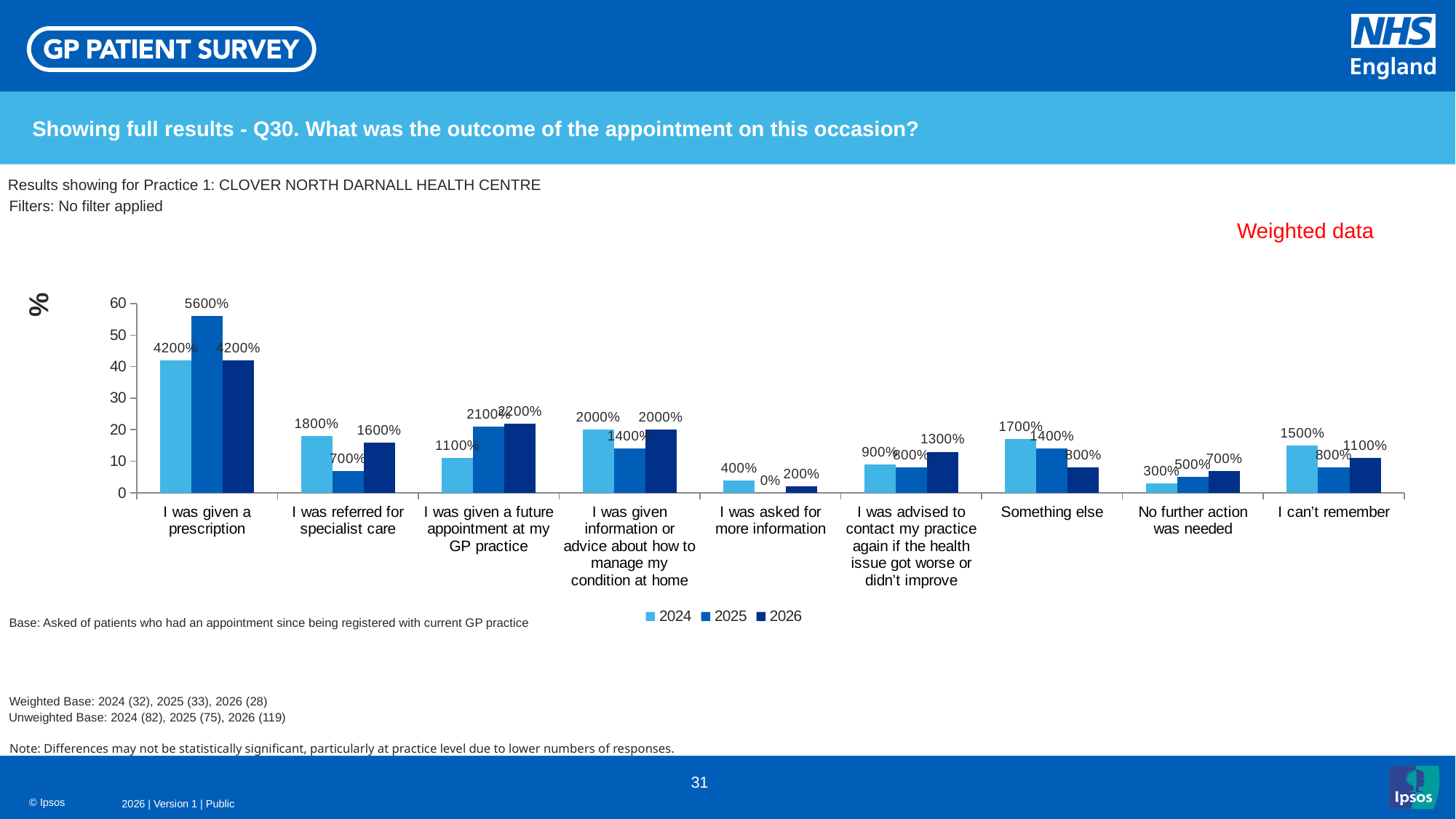
Which is larger for 'Something else': the 2024 value or the 2026 value? 2024 What kind of chart is shown on the slide? Bar chart How many series does the legend list? 3 What is the data label for 2024 on 'I was referred for specialist care'? 1800% How many categories are shown on the x axis? 9 What is the data label for 2025 on 'I was asked for more information'? 0% What is the data label for 2025 on 'I was given a prescription'? 5600% What is the difference between the 2025 and 2024 data labels for 'I was given a prescription'? 1400% What is the data label for 2026 on 'No further action was needed'? 700% Which category has the highest 2026 value? I was given a prescription Which category has the lowest 2024 value? No further action was needed What are the legend entries of the chart? 2024, 2025, 2026